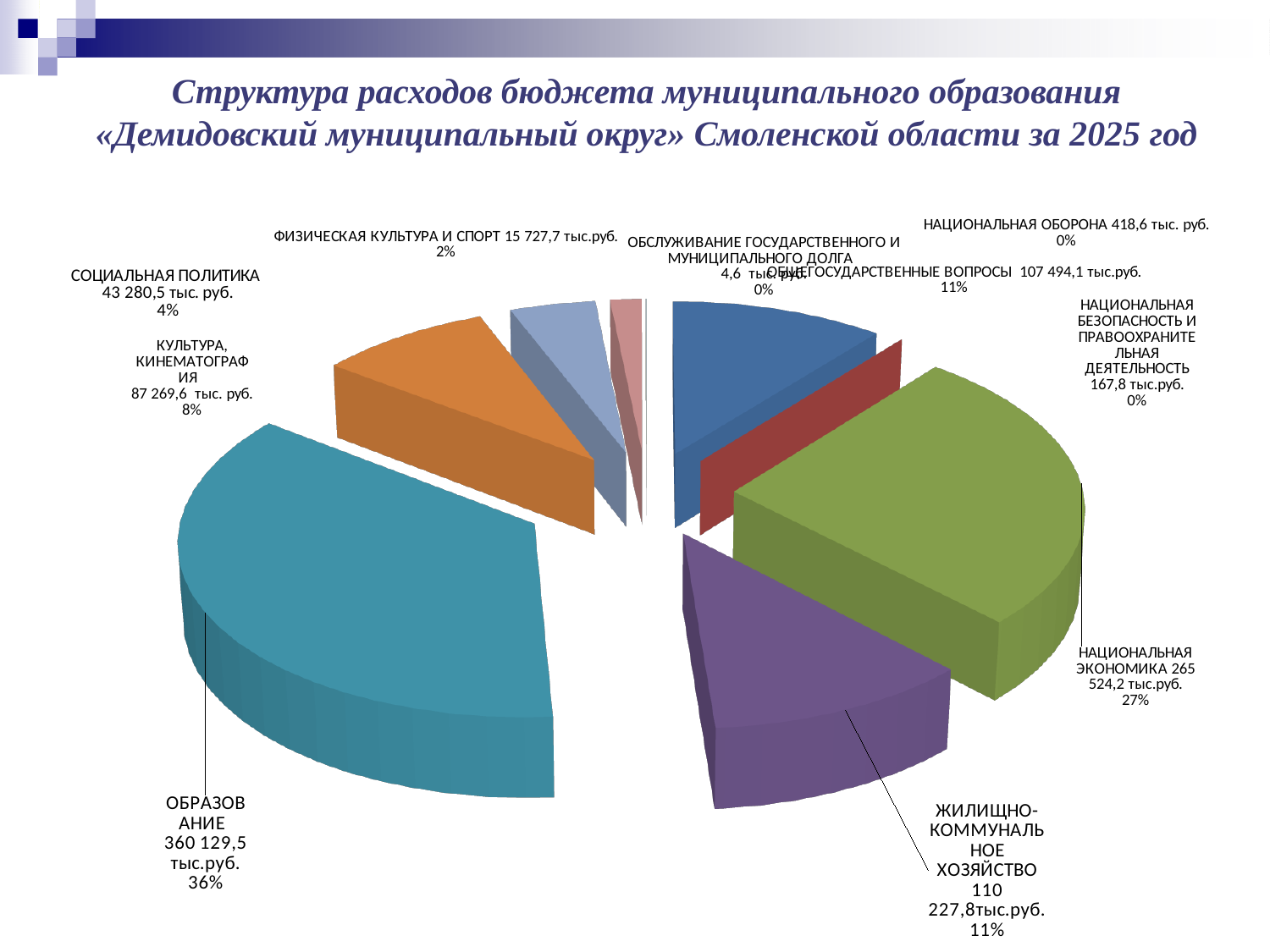
Which is larger, the value for ЖИЛИЩНО-КОММУНАЛЬНОЕ ХОЗЯЙСТВО or the value for ОБЩЕГОСУДАРСТВЕННЫЕ ВОПРОСЫ? ЖИЛИЩНО-КОММУНАЛЬНОЕ ХОЗЯЙСТВО Which year does the chart title say the budget expenditure structure is for? 2025 How many expenditure categories does the pie chart show? 10 What is the value shown for НАЦИОНАЛЬНАЯ ЭКОНОМИКА? 265 524,2 тыс.руб. What is the value shown for ОБРАЗОВАНИЕ? 360 129,5 тыс.руб. What kind of chart is shown on the slide? Pie chart What is the difference between the values for ОБРАЗОВАНИЕ and НАЦИОНАЛЬНАЯ ЭКОНОМИКА? 94 605,3 тыс.руб. What is the value shown for СОЦИАЛЬНАЯ ПОЛИТИКА? 43 280,5 тыс. руб. What share of the pie does КУЛЬТУРА, КИНЕМАТОГРАФИЯ account for? 8% Which category has the smallest value in the pie chart? ОБСЛУЖИВАНИЕ ГОСУДАРСТВЕННОГО И МУНИЦИПАЛЬНОГО ДОЛГА What share of the pie does ОБРАЗОВАНИЕ account for? 36% Which category has the largest share of the pie? ОБРАЗОВАНИЕ